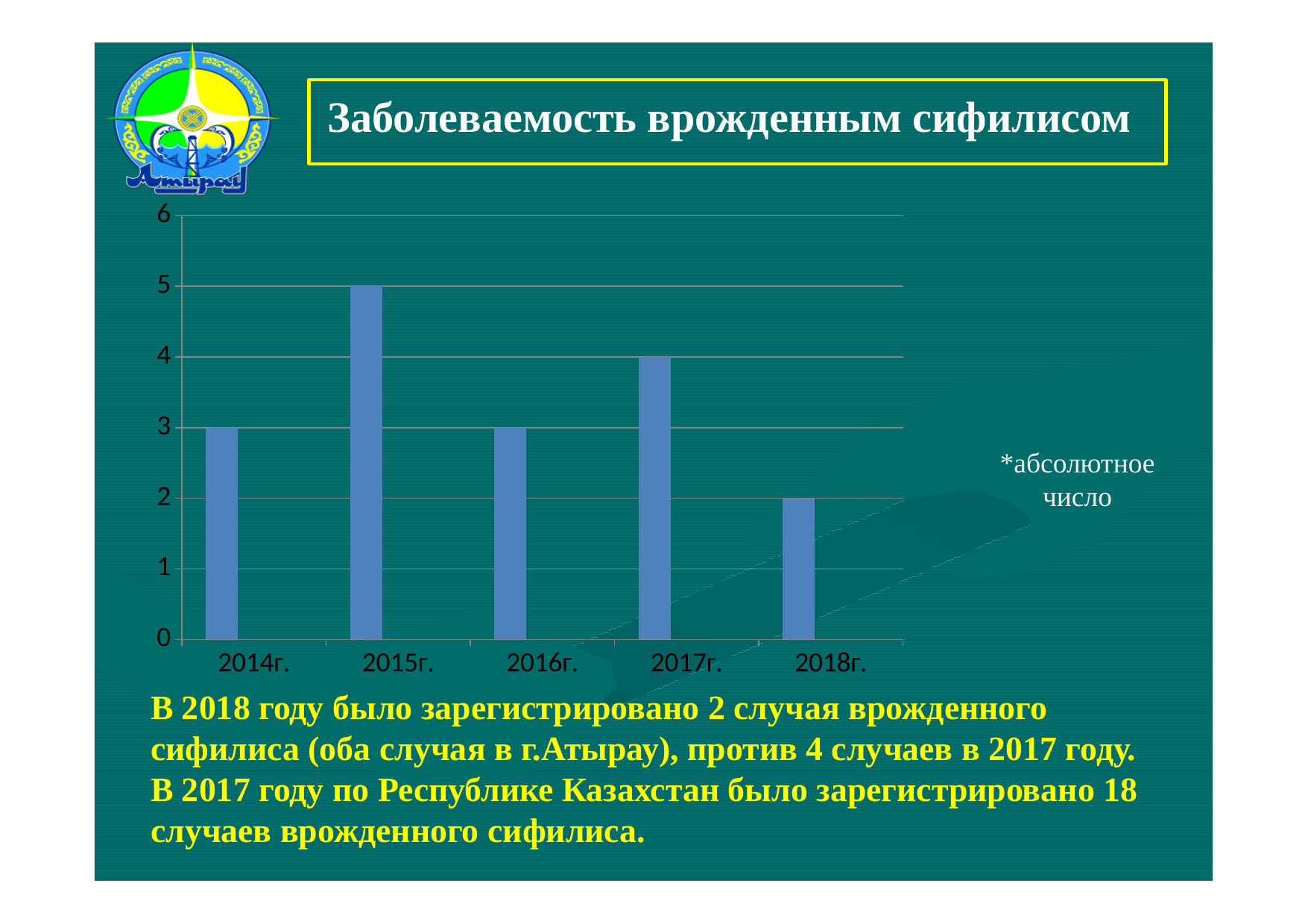
What is the value for 2017г.? 4 What kind of chart is shown on the slide? bar chart What is the difference between the values for 2015г. and 2014г.? 2 What is the difference between the values for 2017г. and 2018г.? 2 How many years are shown on the x axis? 5 Which year has the lowest value? 2018г. What is the title of the chart? Заболеваемость врожденным сифилисом What is the value for 2015г.? 5 Is the value for 2015г. greater or less than 4? greater Which year has the highest value? 2015г. What is the value for 2018г.? 2 Which is larger, the value for 2016г. or the value for 2017г.? 2017г.